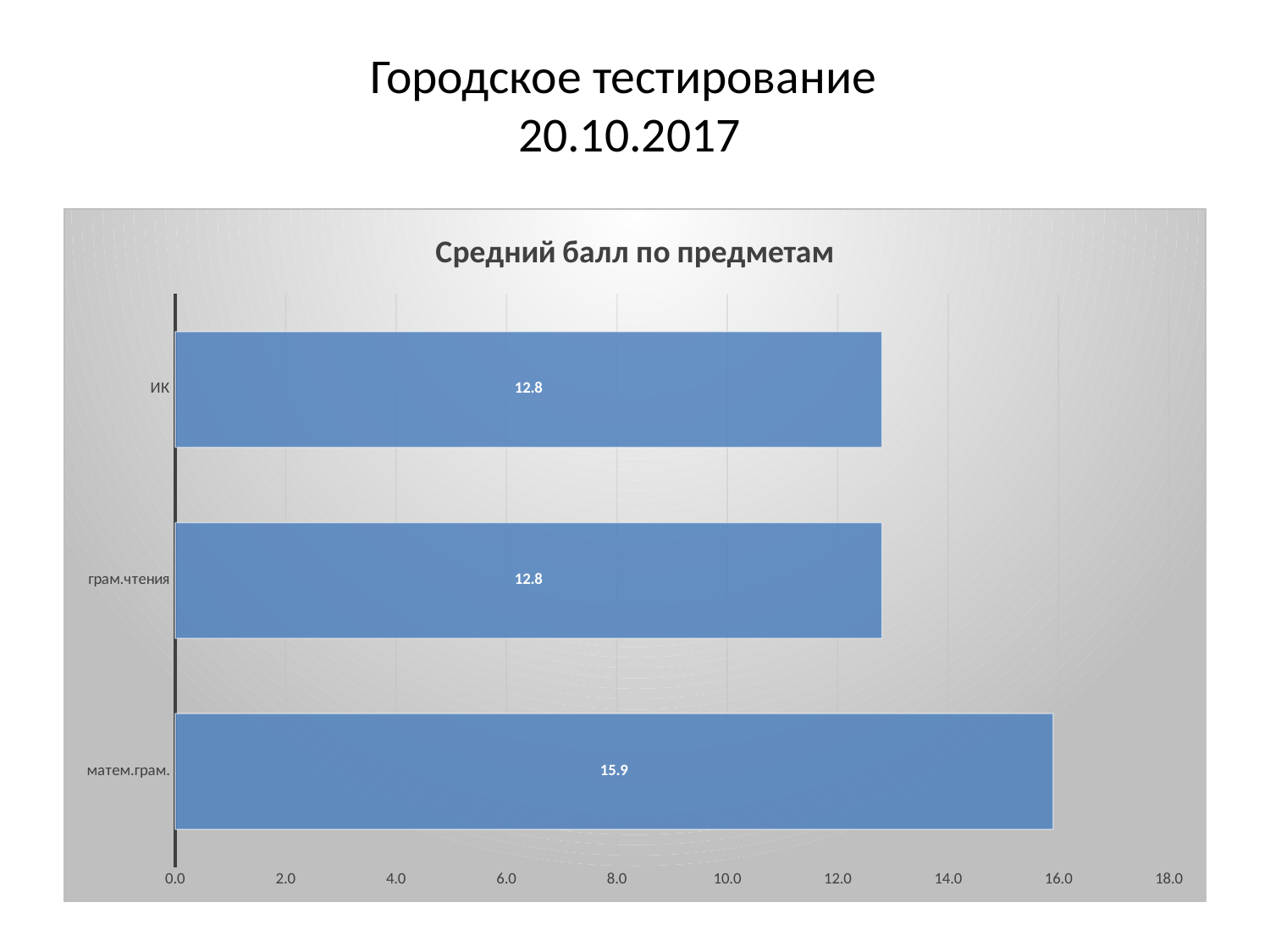
Is the value for ИК greater or less than 14.0? less What is the value for ИК? 12.8 What is the difference between the values for матем.грам. and ИК? 3.1 What is the maximum value shown on the horizontal axis? 18.0 What kind of chart is shown on the slide? bar chart Is the value for матем.грам. greater or less than 14.0? greater What is the value for матем.грам.? 15.9 Which category has the highest value? матем.грам. How many categories are shown in the chart? 3 What is the value for грам.чтения? 12.8 What is the title of the chart? Средний балл по предметам Which is larger, the value for матем.грам. or the value for грам.чтения? матем.грам.